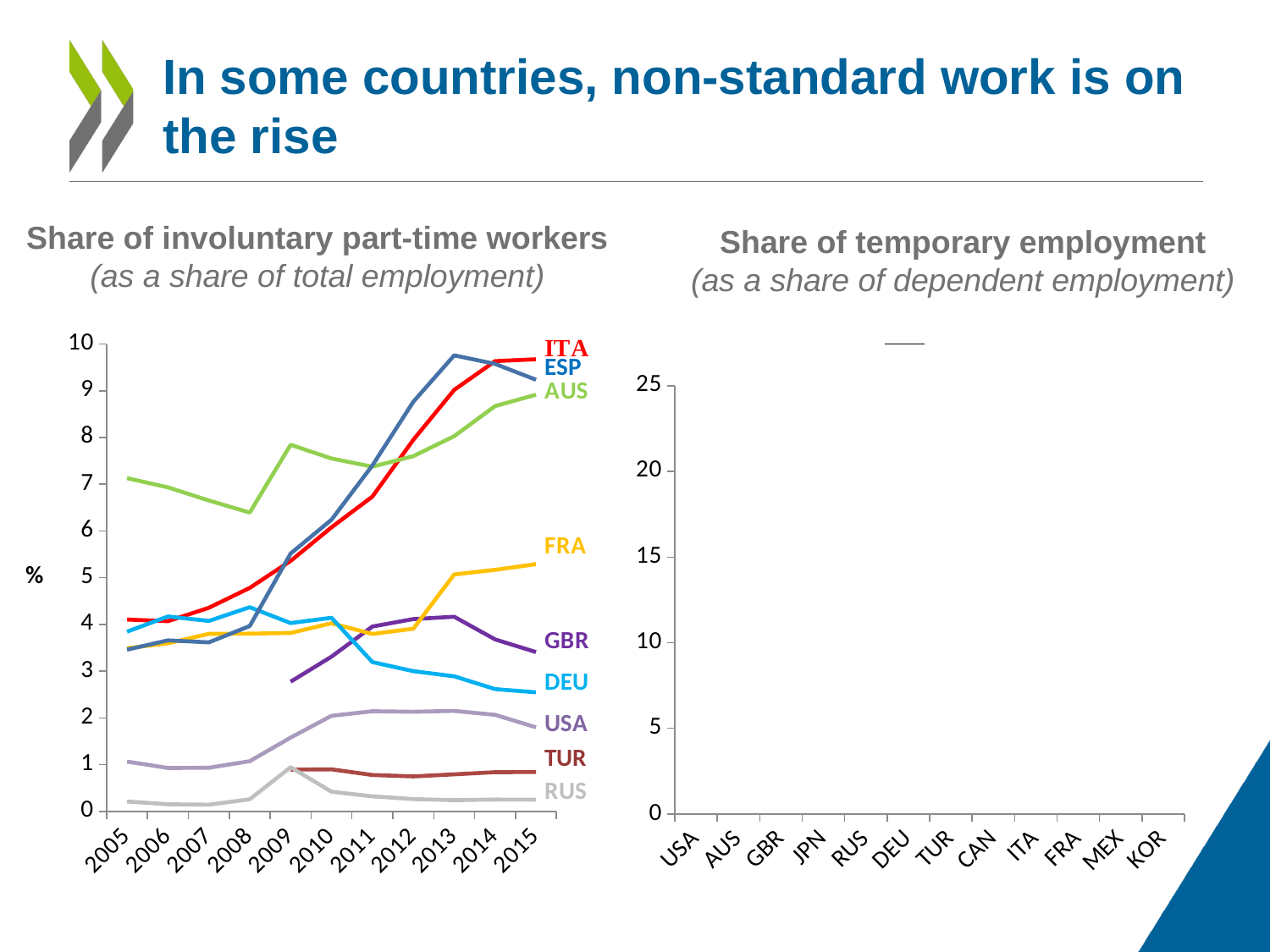
On the right chart, 'Share of temporary employment', how many countries are listed on the x axis? 12 On the left chart, 'Share of involuntary part-time workers', what is the label on the y axis? % On the left chart, 'Share of involuntary part-time workers', is the value for AUS in 2005 greater or less than 6? greater On the left chart, 'Share of involuntary part-time workers', how many years are shown on the x axis? 11 On the left chart, 'Share of involuntary part-time workers', which country has the highest value in 2005? AUS On the left chart, 'Share of involuntary part-time workers', does the DEU line rise or fall from 2005 to 2015? fall On the left chart, 'Share of involuntary part-time workers', does the ITA line rise or fall from 2005 to 2015? rise On the left chart, 'Share of involuntary part-time workers', which is larger in 2015, ITA or FRA? ITA On the left chart, 'Share of involuntary part-time workers', which country has the lowest value in 2015? RUS On the left chart, 'Share of involuntary part-time workers', is the value for USA in 2015 greater or less than 3? less On the left chart, 'Share of involuntary part-time workers', how many country series are plotted? 9 On the left chart, 'Share of involuntary part-time workers', what kind of chart is it? line chart